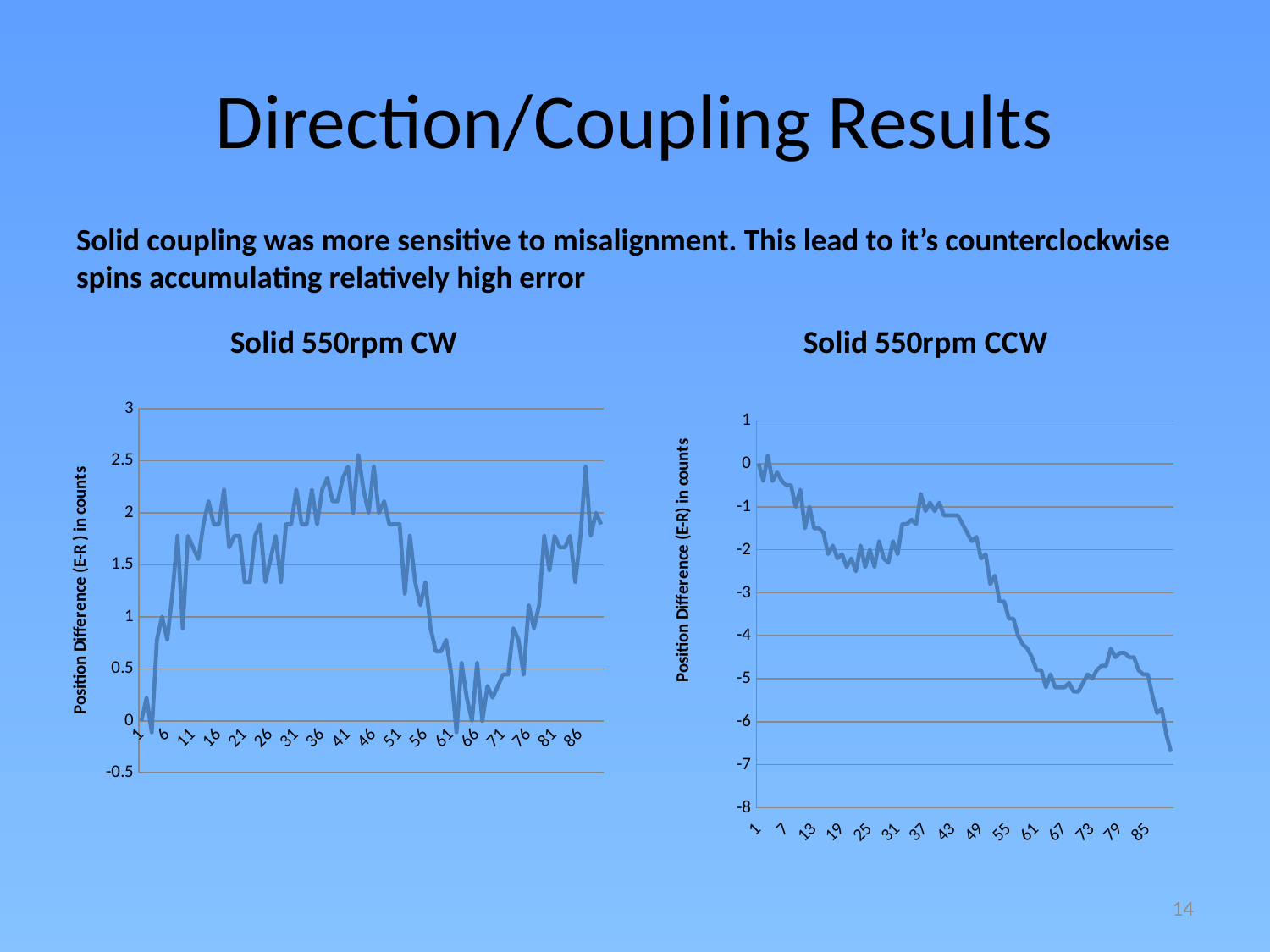
In the 'Solid 550rpm CW' chart, is the value at x = 66 greater or less than 1? less In the 'Solid 550rpm CW' chart, do the values rise or fall between x = 1 and x = 41? rise In the 'Solid 550rpm CCW' chart, is the value at x = 55 greater or less than -3? less What kind of chart is the 'Solid 550rpm CW' chart? line chart In the 'Solid 550rpm CCW' chart, do the values generally rise or fall along the x axis? fall What is the y-axis label of the 'Solid 550rpm CCW' chart? Position Difference (E-R) in counts What is the title of the chart on the left side of the slide? Solid 550rpm CW In the 'Solid 550rpm CW' chart, is the value at x = 6 greater or less than 0.5? greater What kind of chart is the 'Solid 550rpm CCW' chart? line chart